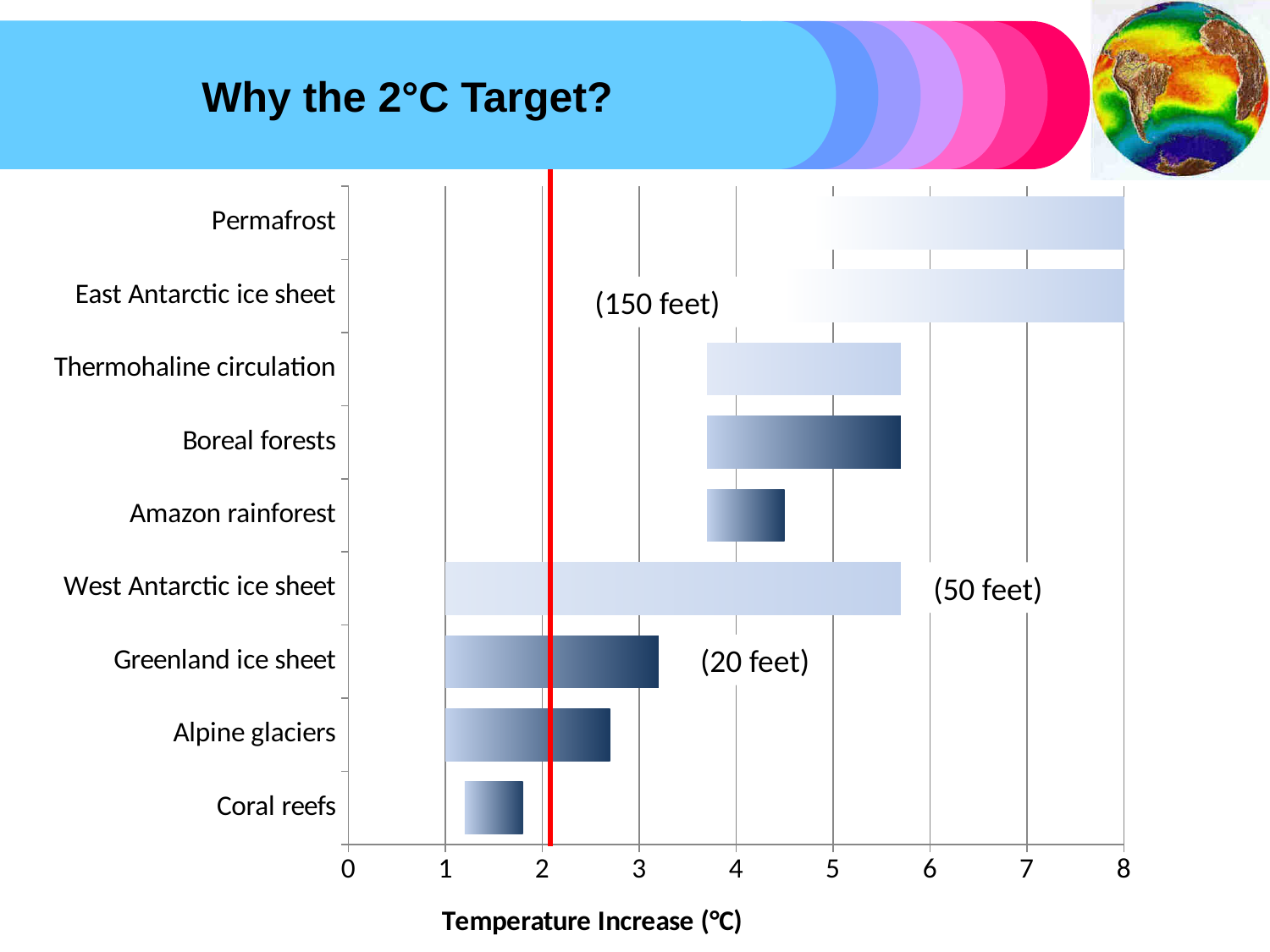
What sea-level rise annotation is printed next to the West Antarctic ice sheet bar? (50 feet) Is the upper end of the Coral reefs bar greater or less than 2? less Which bar extends further to the right, Greenland ice sheet or Alpine glaciers? Greenland ice sheet At what temperature increase does the Permafrost bar end on the horizontal axis? 8 Is the upper end of the Amazon rainforest bar greater or less than 4? greater How many categories are listed on the vertical axis of the chart? 9 Is the lower end of the Thermohaline circulation bar greater or less than 3? greater What kind of chart is shown on the slide? bar chart Which category's bar extends furthest to the right, Coral reefs or Permafrost? Permafrost Which category has the bar with the lowest upper end? Coral reefs At what temperature increase does the Greenland ice sheet bar begin on the horizontal axis? 1 What is the title of the horizontal axis of the chart? Temperature Increase (°C)